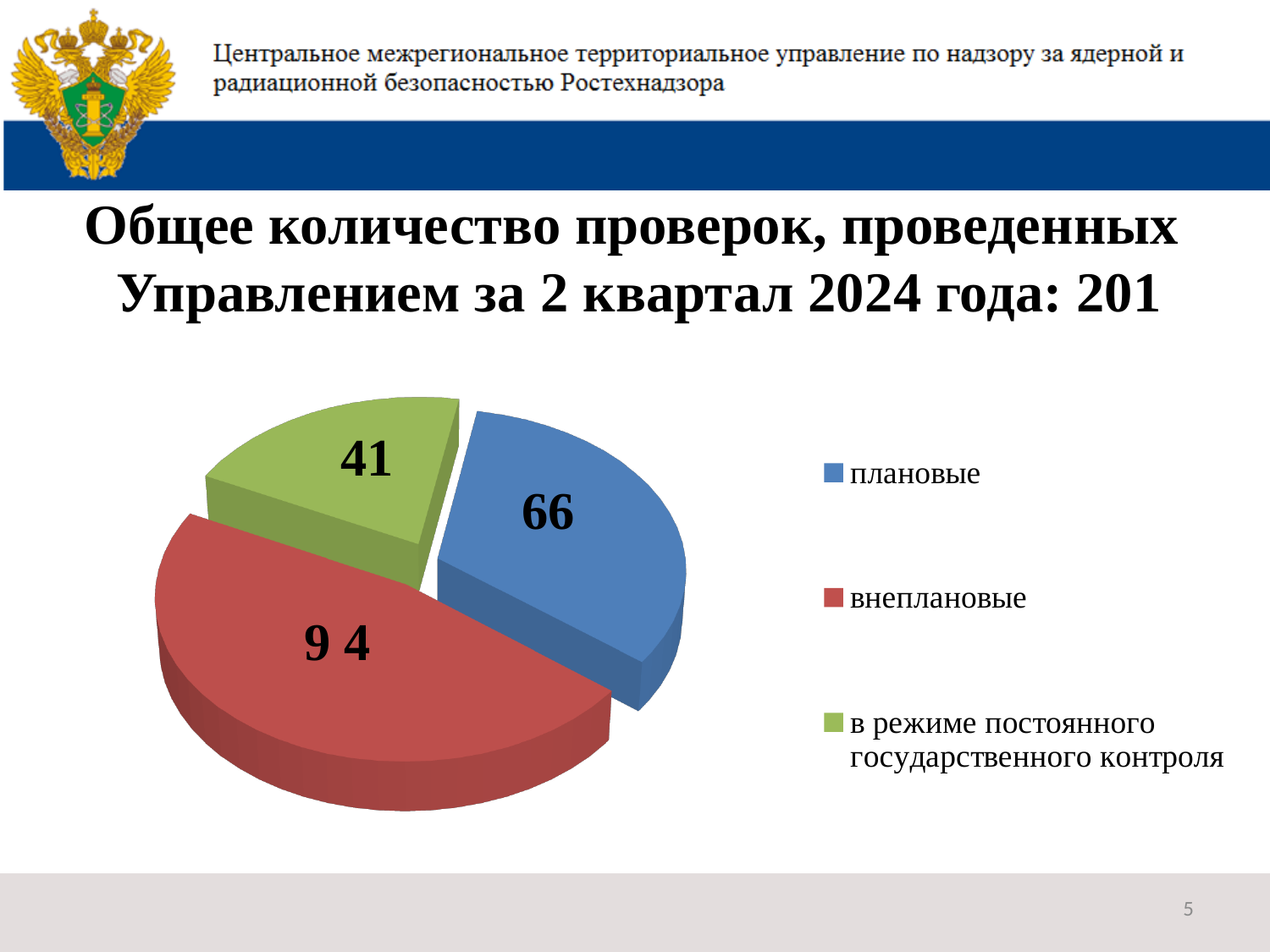
How many slices does the pie chart have? 3 What colour is the slice for внеплановые in the pie chart? red What is the value for плановые in the pie chart? 66 What is the difference between the values for внеплановые and плановые? 28 What is the value for в режиме постоянного государственного контроля in the pie chart? 41 How many entries does the legend of the pie chart list? 3 Which category has the largest slice in the pie chart? внеплановые What is the difference between the values for плановые and в режиме постоянного государственного контроля? 25 Which category has the smallest slice in the pie chart? в режиме постоянного государственного контроля What is the value for внеплановые in the pie chart? 94 Which is larger, the value for плановые or the value for в режиме постоянного государственного контроля? плановые What kind of chart is shown on the slide? pie chart